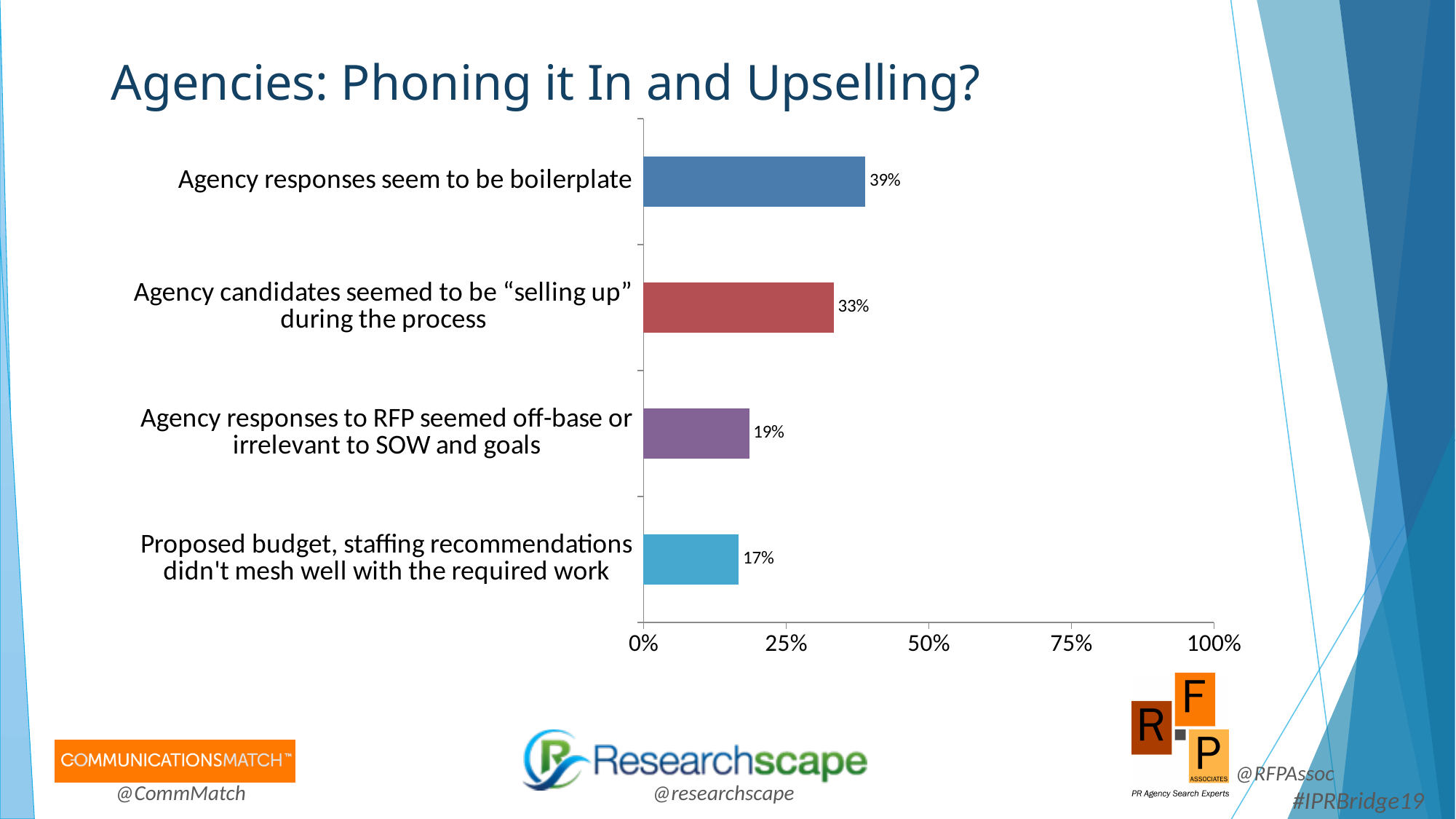
What is the value for "Agency candidates seemed to be "selling up" during the process"? 33% What percentage of respondents said agency responses seem to be boilerplate? 39% Which category has the highest value? Agency responses seem to be boilerplate What is the title of the slide? Agencies: Phoning it In and Upselling? What is the value for "Proposed budget, staffing recommendations didn't mesh well with the required work"? 17% Is the value for "Agency responses seem to be boilerplate" greater or less than 50%? less What kind of chart is shown on the slide? Bar chart Which category has the lowest value? Proposed budget, staffing recommendations didn't mesh well with the required work How many categories are shown in the chart? 4 Which is larger: the value for "Agency responses to RFP seemed off-base or irrelevant to SOW and goals" or the value for "Proposed budget, staffing recommendations didn't mesh well with the required work"? Agency responses to RFP seemed off-base or irrelevant to SOW and goals What percentage is shown for "Agency responses to RFP seemed off-base or irrelevant to SOW and goals"? 19% What is the difference between the value for "Agency responses seem to be boilerplate" and the value for "Agency candidates seemed to be "selling up" during the process"? 6%